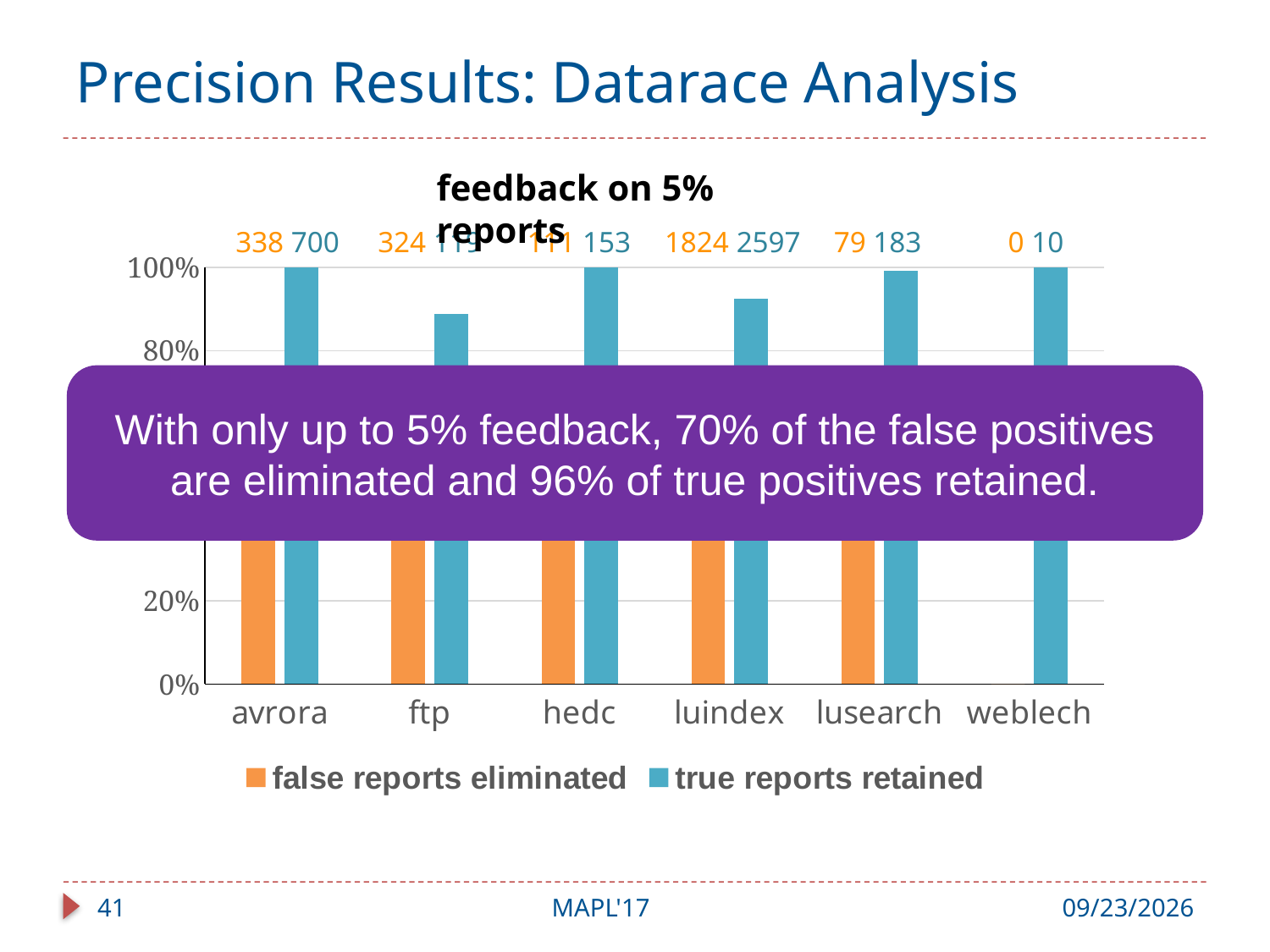
Is the value of true reports retained for luindex greater or less than 80%? greater How many categories are shown along the x axis of the chart? 6 How many series does the chart's legend list? 2 What is the title of the chart? feedback on 5% reports Which category has the lowest value of true reports retained? ftp What numbers are printed above the bars for luindex? 1824 2597 Is the value of true reports retained for ftp greater or less than 80%? greater What are the two series named in the chart's legend? false reports eliminated, true reports retained What numbers are printed above the bars for avrora? 338 700 Is the value of true reports retained for lusearch greater or less than 80%? greater What kind of chart is shown on the slide? bar chart Which is larger, true reports retained for avrora or true reports retained for ftp? avrora